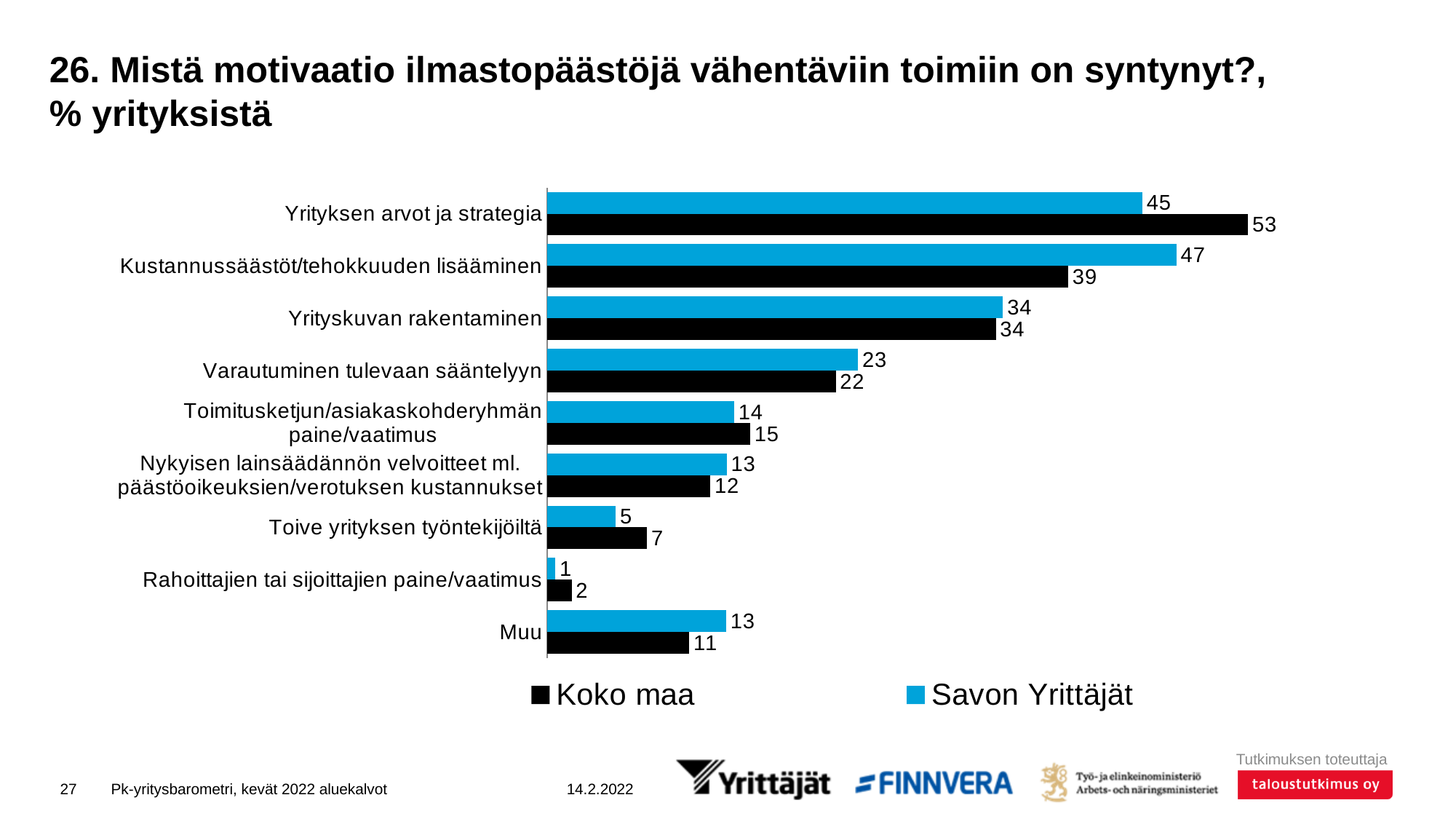
What kind of chart is shown on the slide? Bar chart Which category has the lowest value for Savon Yrittäjät? Rahoittajien tai sijoittajien paine/vaatimus Which colour represents the Savon Yrittäjät series? Blue Which category has the highest value for Koko maa? Yrityksen arvot ja strategia For 'Kustannussäästöt/tehokkuuden lisääminen', which series has the larger value, Koko maa or Savon Yrittäjät? Savon Yrittäjät What is the difference between the Koko maa and Savon Yrittäjät values for 'Yrityksen arvot ja strategia'? 8 How many categories are shown in the chart? 9 What is the value for Savon Yrittäjät for 'Muu'? 13 What is the value for Koko maa for 'Yrityksen arvot ja strategia'? 53 What is the value for Savon Yrittäjät for 'Kustannussäästöt/tehokkuuden lisääminen'? 47 What is the value for Koko maa for 'Toive yrityksen työntekijöiltä'? 7 How many series does the legend list? 2